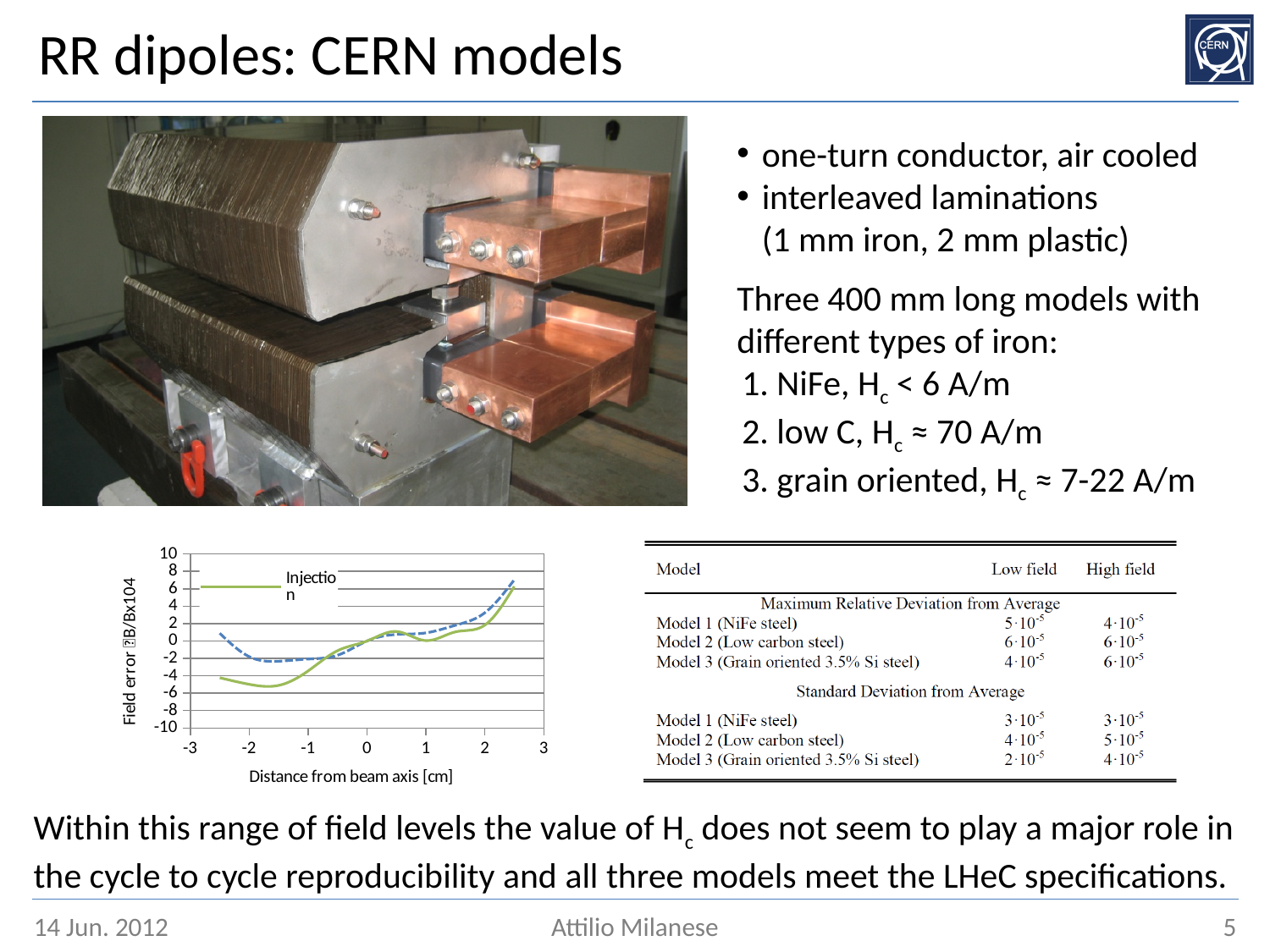
What kind of chart is shown at the bottom left of the slide? line chart In the line chart, is the lowest value of the solid line greater or less than -4? less In the line chart, does the solid line rise or fall as the distance goes from -2.5 cm to -1.5 cm? fall What is the x-axis title of the line chart? Distance from beam axis [cm] In the line chart, is the value of the solid line at its right end (around 2.5 cm) greater or less than 4? greater What is the y-axis title of the line chart? Field error ΔB/Bx104 In the line chart, is the value of the dashed line at its right end (around 2.5 cm) greater or less than 4? greater What is the highest value shown on the y axis of the line chart? 10 In the line chart, at a distance of -2 cm, which line has the higher value, the solid line or the dashed line? the dashed line In the line chart, does the solid line rise or fall as the distance goes from 0 cm to 2.5 cm? rise